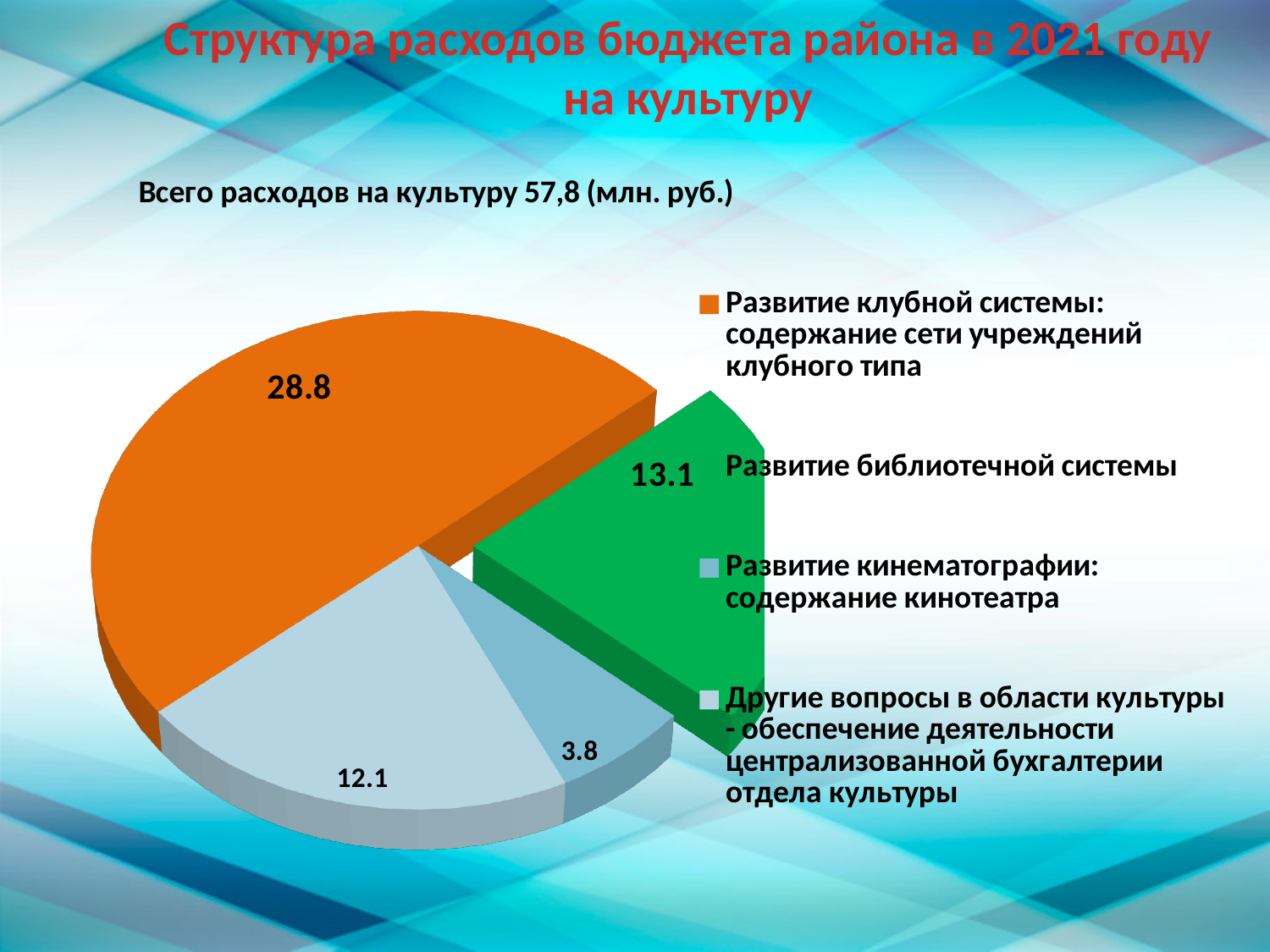
What colour is the slice for «Развитие библиотечной системы»? Green What is the difference between the values for «Развитие клубной системы» and «Развитие библиотечной системы»? 15.7 What is the total of all the slices in the pie chart? 57.8 Which is larger: the value for «Развитие библиотечной системы» or for «Другие вопросы в области культуры»? Развитие библиотечной системы What is the value for «Развитие клубной системы: содержание сети учреждений клубного типа»? 28.8 Which category has the largest slice of the pie? Развитие клубной системы: содержание сети учреждений клубного типа What type of chart is shown on the slide? Pie chart What is the value for «Развитие библиотечной системы»? 13.1 How many slices does the pie chart have? 4 What is the value for «Другие вопросы в области культуры - обеспечение деятельности централизованной бухгалтерии отдела культуры»? 12.1 What is the value for «Развитие кинематографии: содержание кинотеатра»? 3.8 Which category has the smallest slice of the pie? Развитие кинематографии: содержание кинотеатра